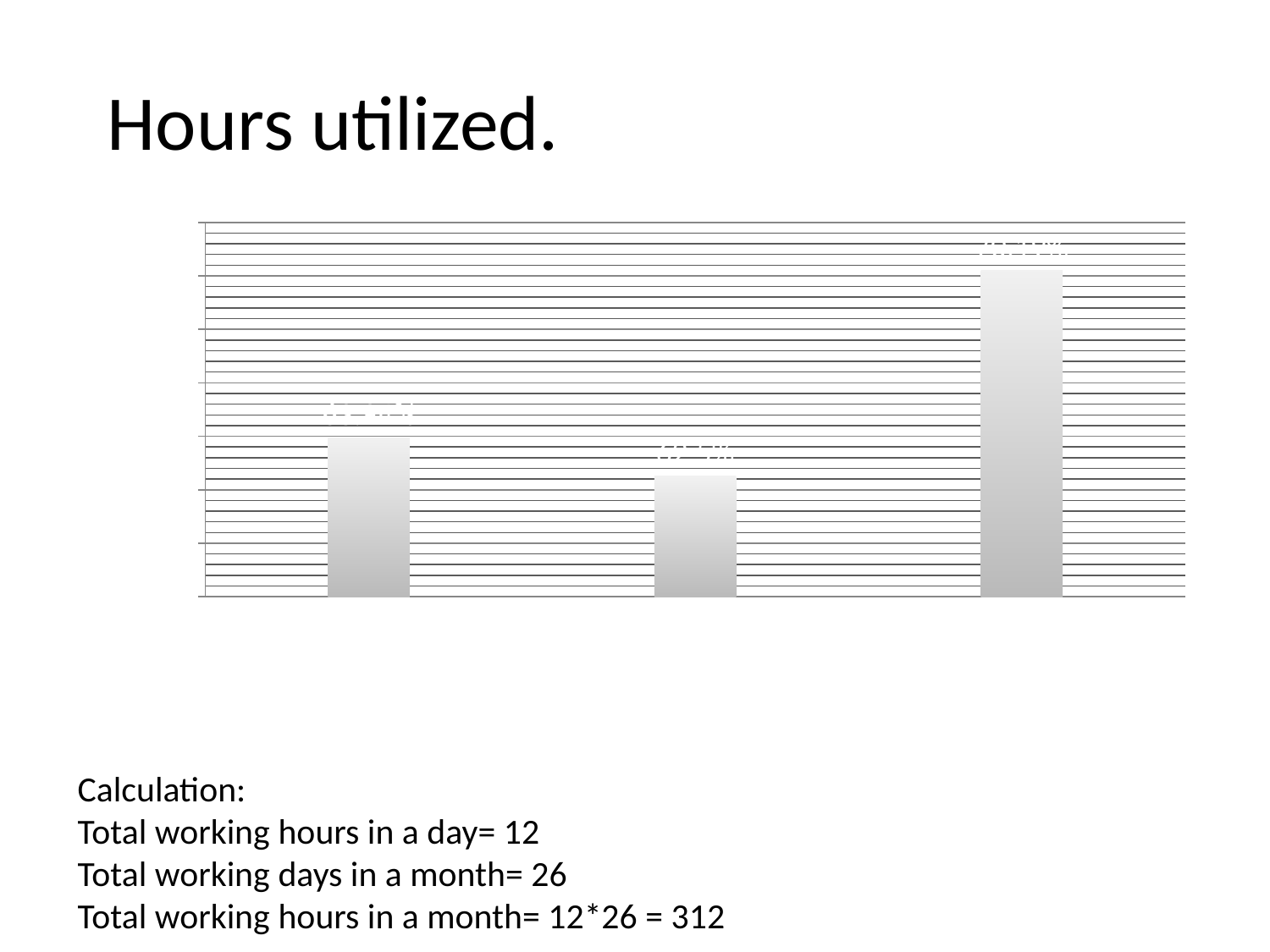
Which bar is the shortest in the chart: the left, middle, or right bar? middle bar Which bar is the tallest in the chart: the left, middle, or right bar? right bar Which is taller, the left bar or the right bar? right bar Does the chart display a legend? No Do the bar heights rise steadily from left to right across the chart? No Which is taller, the left bar or the middle bar? left bar What kind of chart is shown on the slide? bar chart Which is taller, the middle bar or the right bar? right bar How many bars does the chart show? 3 What is the title shown above the chart on the slide? Hours utilized.